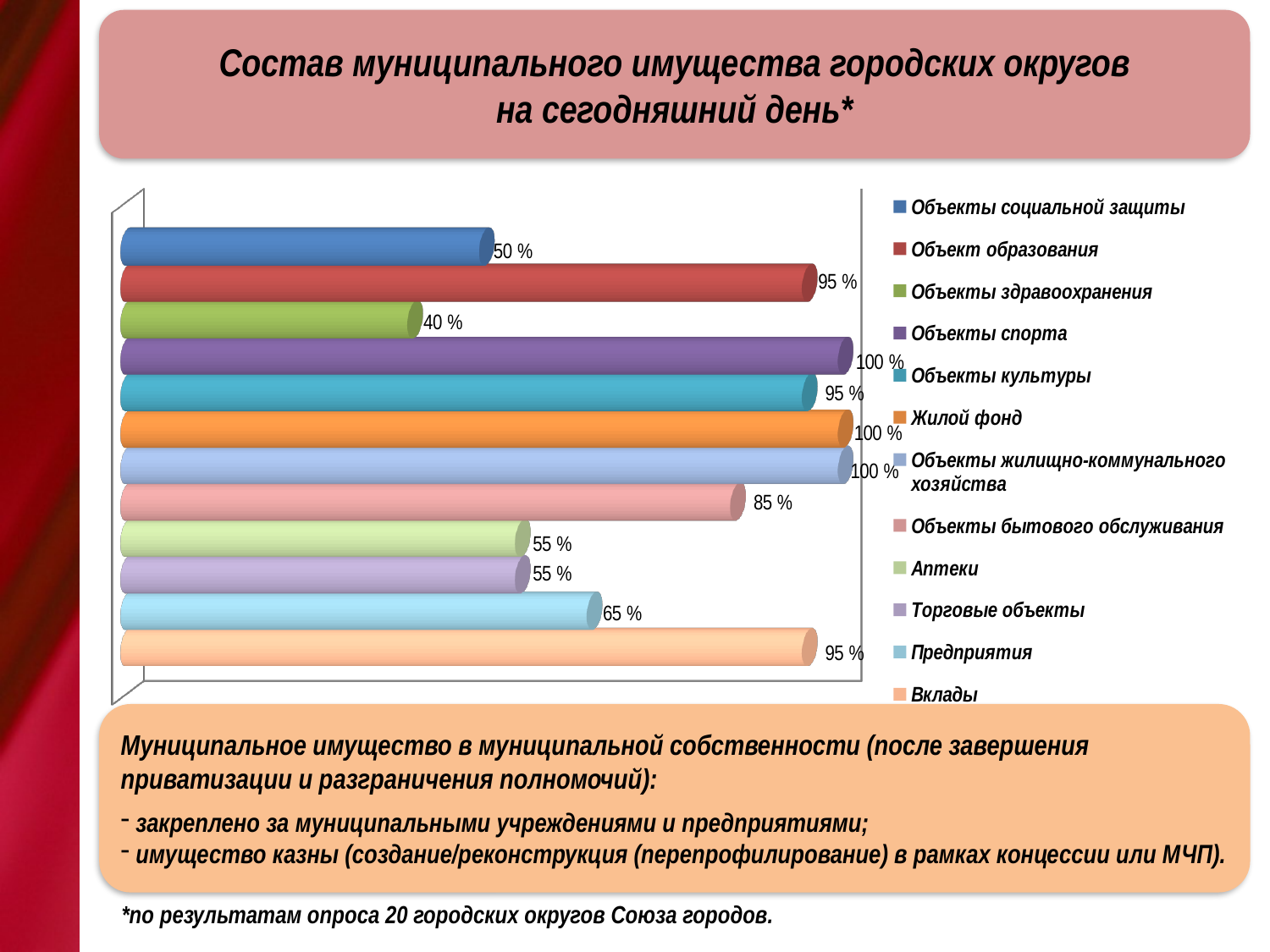
What is the value for Объекты бытового обслуживания? 85 % What kind of chart is shown on the slide? bar chart What is the value for Вклады? 95 % How many bars are plotted in the chart? 12 How many entries does the legend list? 12 What is the difference between the values for Жилой фонд and Предприятия? 35 % What is the value for Объекты социальной защиты? 50 % What is the value for Предприятия? 65 % What is the value for Объекты здравоохранения? 40 % Which category has the lowest value? Объекты здравоохранения Which is larger, the value for Объекты бытового обслуживания or the value for Аптеки? Объекты бытового обслуживания What is the difference between the values for Объект образования and Объекты социальной защиты? 45 %